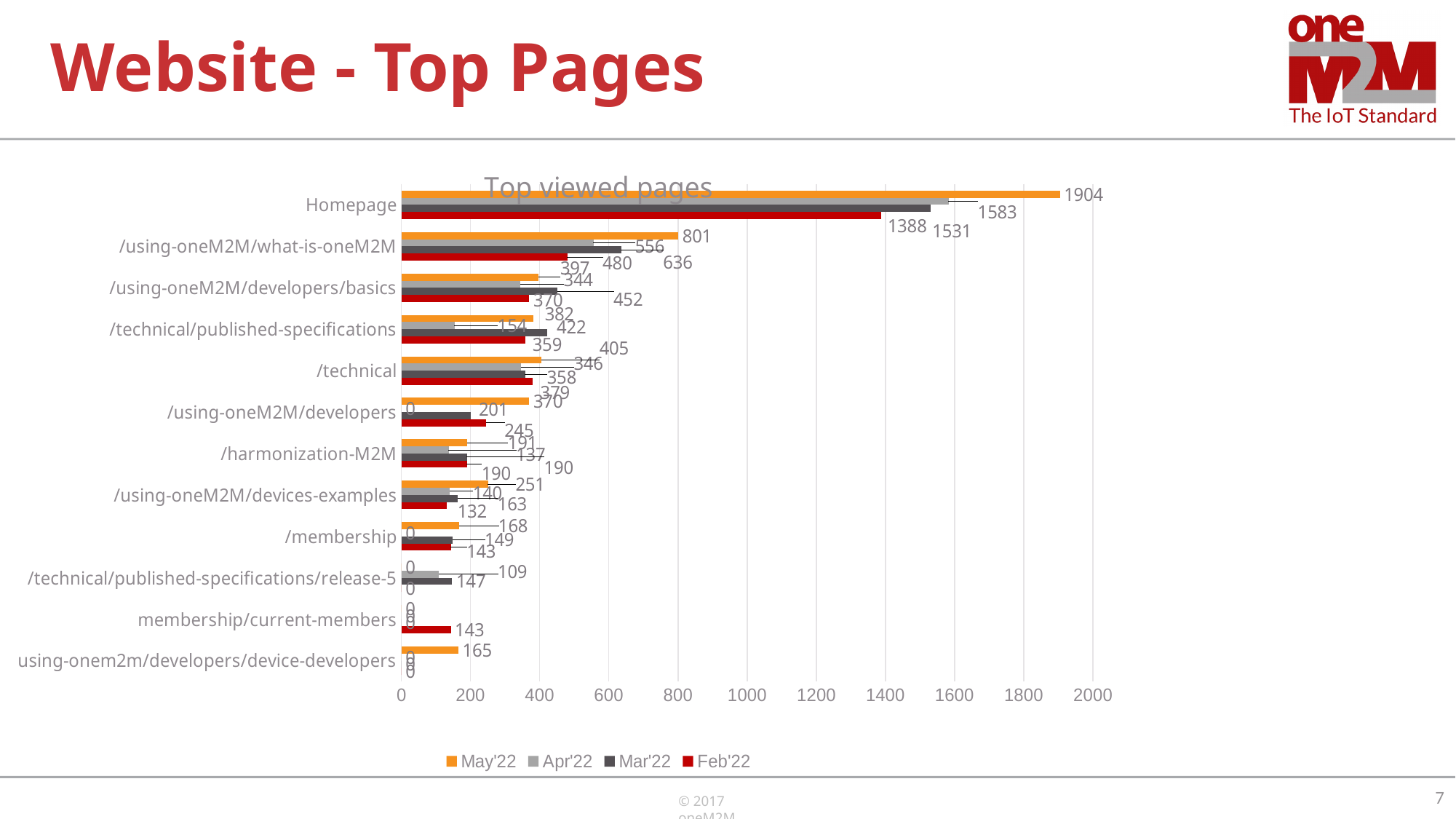
Is the Feb'22 value for Homepage greater or less than 1200? greater What is the Feb'22 value for membership/current-members? 143 What is the May'22 value for Homepage? 1904 What is the May'22 value for using-onem2m/developers/device-developers? 165 What type of chart is shown on the slide? Bar chart What is the difference between the May'22 and Apr'22 values for Homepage? 321 What is the May'22 value for /using-oneM2M/what-is-oneM2M? 801 Which page has the highest May'22 value? Homepage For Homepage, which is larger: the Mar'22 value or the Feb'22 value? Mar'22 How many series does the legend list? 4 How many pages (categories) are shown on the chart? 12 What is the Apr'22 value for Homepage? 1583